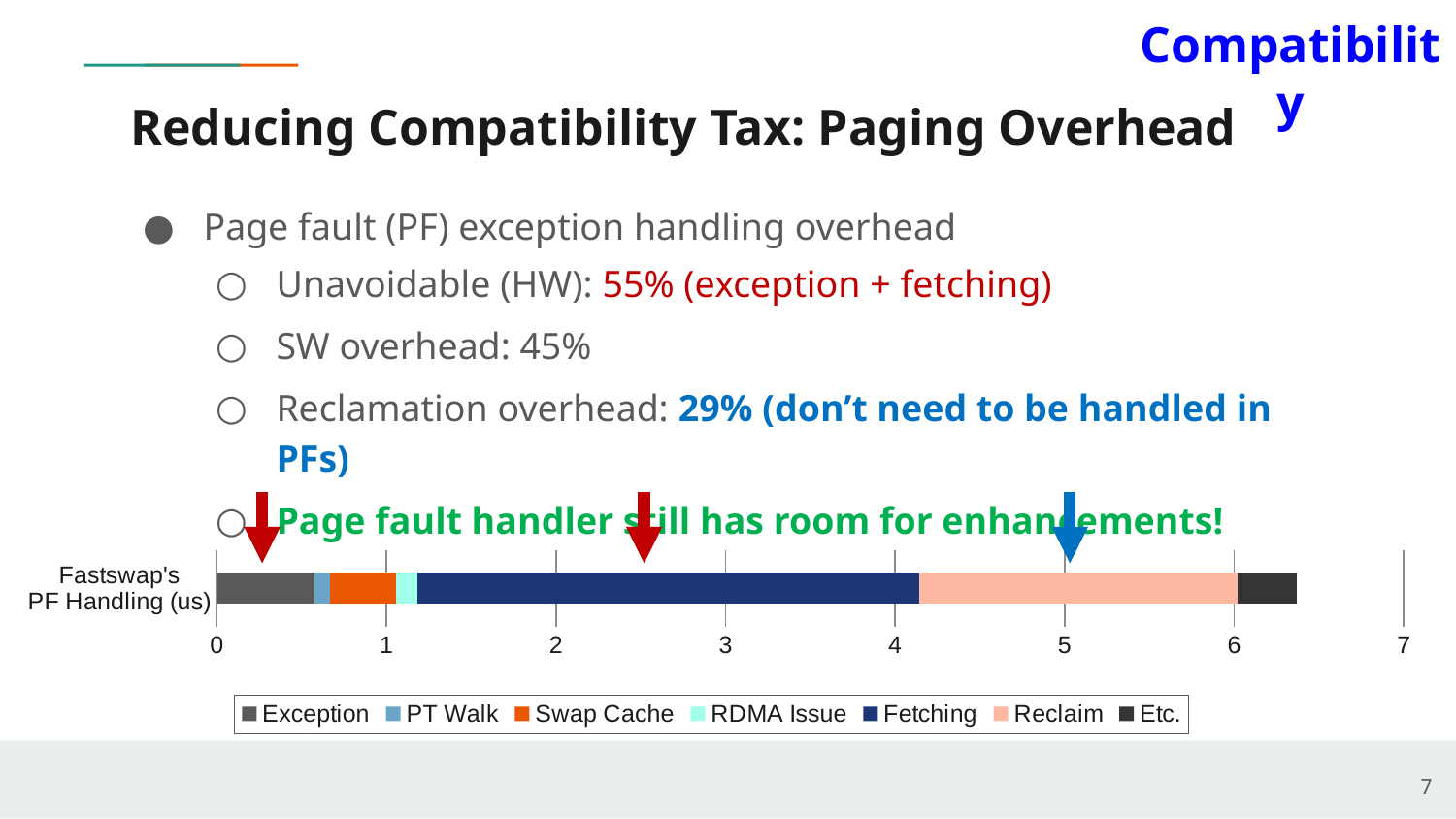
Which segment is larger in the bar, Fetching or Reclaim? Fetching Which segment is larger in the bar, Exception or PT Walk? Exception How many categories (bars) are plotted in the chart? 1 Which series is listed last in the chart legend? Etc. Is the width of the Fetching segment greater or less than 2? greater What kind of chart is shown on the slide? Stacked bar chart Is the width of the Exception segment greater or less than 1? less What is the highest value shown on the x axis of the chart? 7 What is the label of the single bar in the chart? Fastswap's PF Handling (us) Which series occupies the largest segment of the Fastswap's PF Handling bar? Fetching Is the total length of the Fastswap's PF Handling bar greater or less than 6? greater How many series does the chart legend list? 7